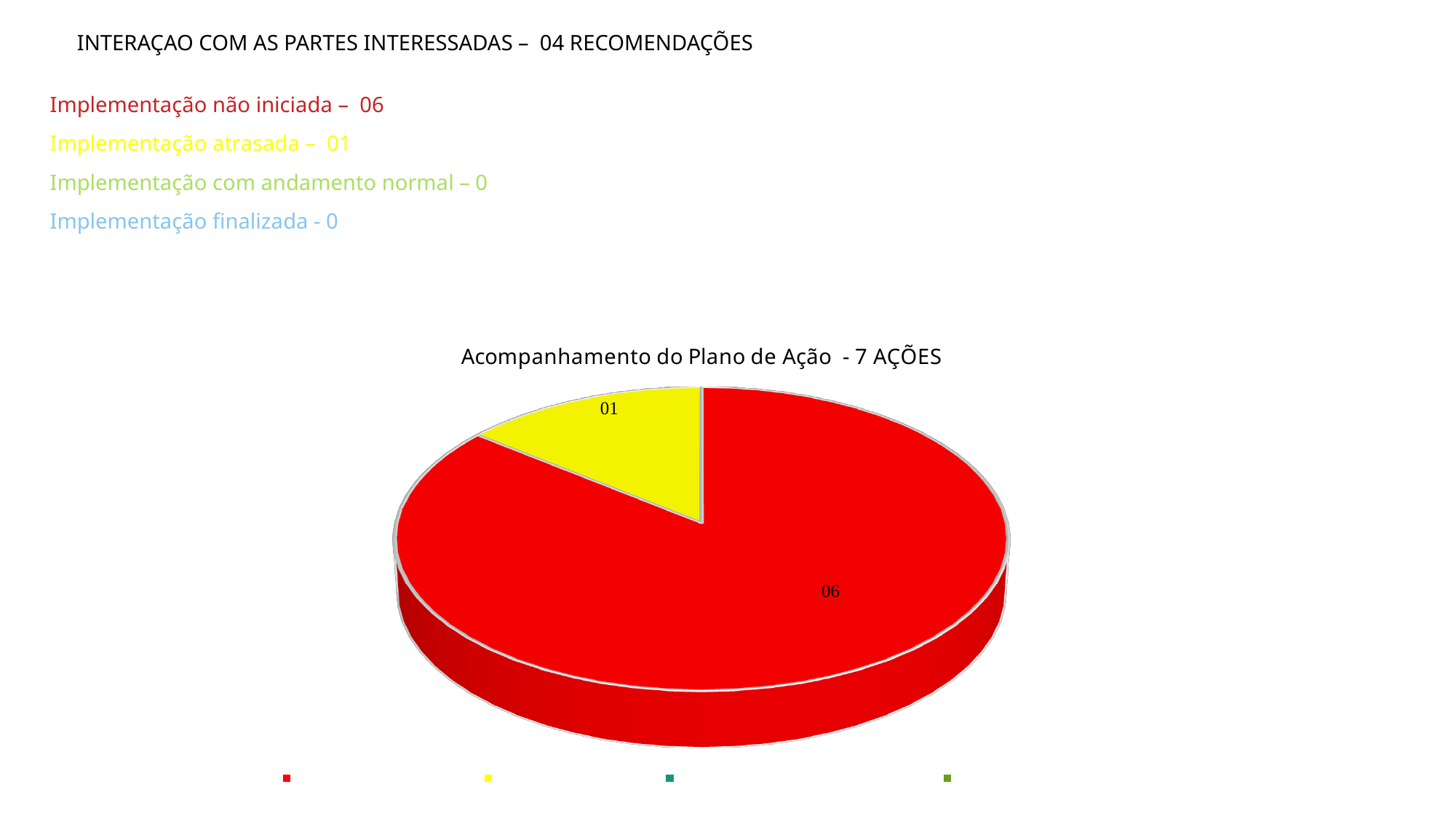
Which is larger, the red slice or the yellow slice? the red slice What is the title of the chart? Acompanhamento do Plano de Ação - 7 AÇÕES What value is printed on the red slice of the pie chart? 06 What colour is the slice labelled 01? yellow How many slices with data labels are visible in the pie chart? 2 What kind of chart is shown on the slide? pie chart Which labelled slice of the pie chart is the smallest? the yellow slice (01) What is the total of the values printed on the pie chart slices? 7 Which slice of the pie chart is the largest? the red slice (06) How many colour markers does the chart legend show? 4 What value is printed on the yellow slice of the pie chart? 01 What is the difference between the value of the red slice and the value of the yellow slice? 5